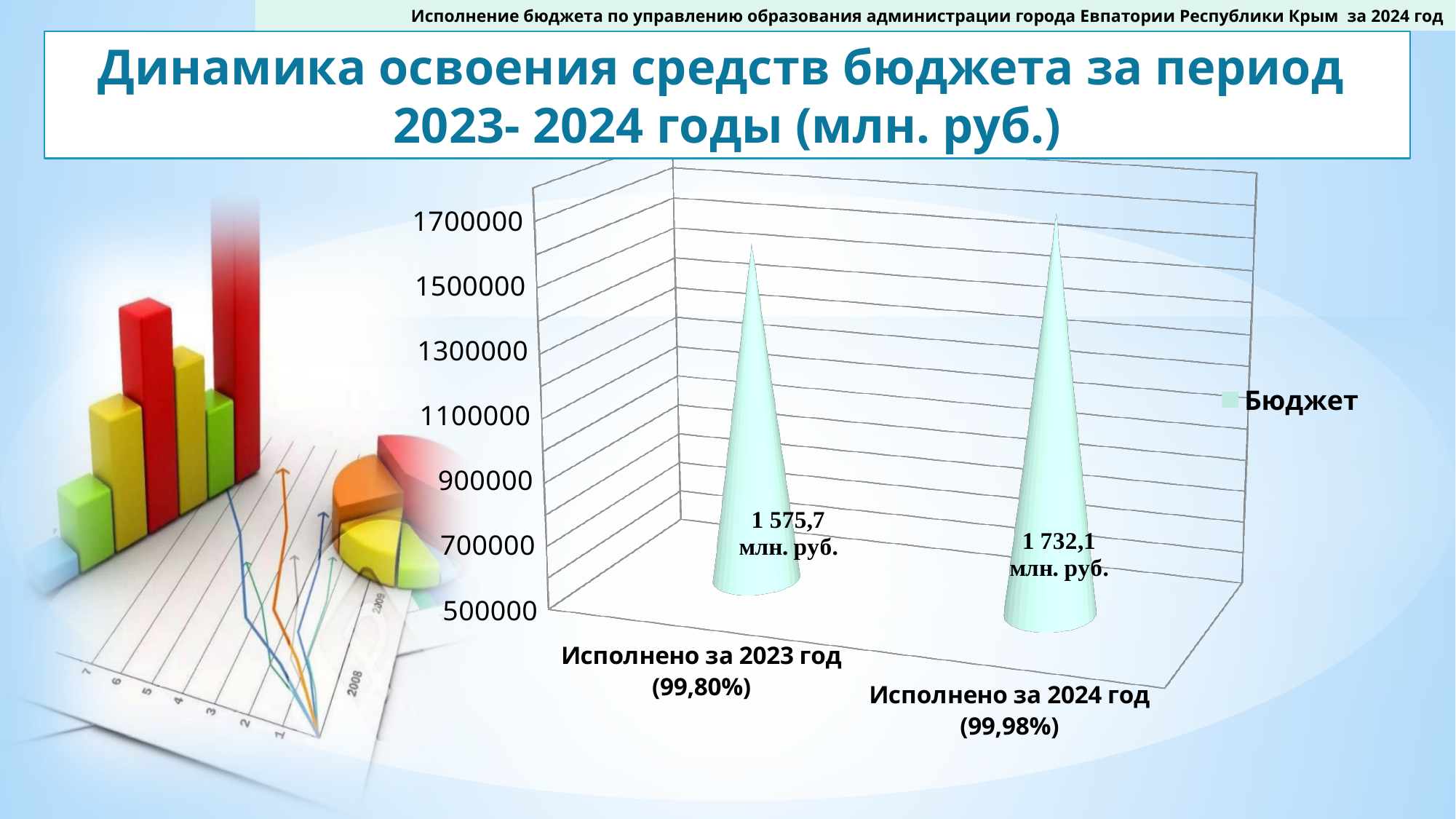
How many categories are plotted on the chart? 2 Which category has the highest value? Исполнено за 2024 год Which is larger: the value for 2023 or the value for 2024? 2024 Is the value for "Исполнено за 2023 год" greater or less than 1300000 on the axis? greater How many series does the legend list? 1 Which category has the lowest value? Исполнено за 2023 год What is the name of the series in the legend? Бюджет What is the value shown for "Исполнено за 2024 год"? 1 732,1 млн. руб. What is the difference between the 2024 value and the 2023 value? 156,4 млн. руб. Do the values rise or fall from 2023 to 2024? rise What is the value shown for "Исполнено за 2023 год"? 1 575,7 млн. руб. What kind of chart is shown on the slide? bar chart